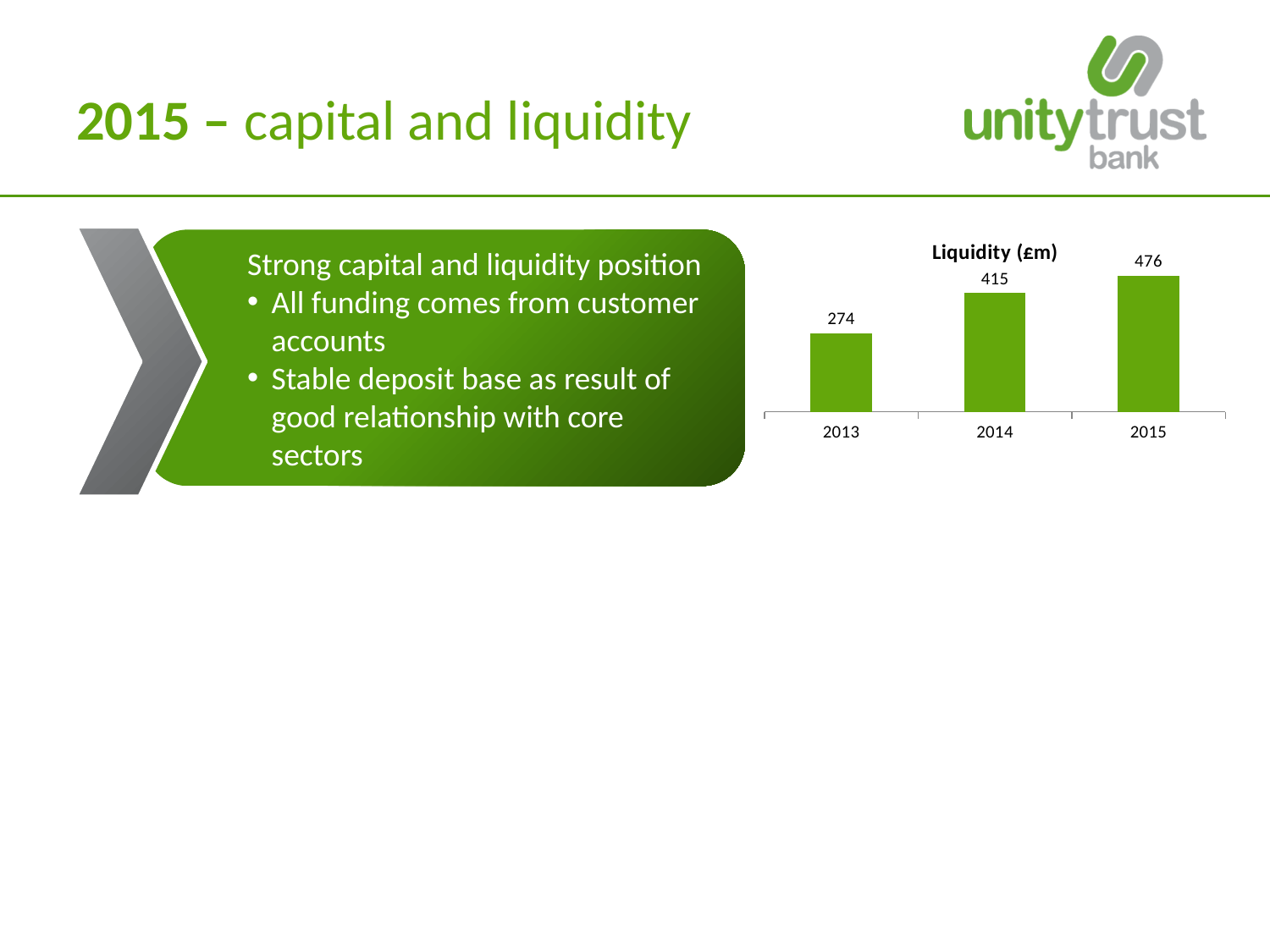
Does liquidity rise or fall from 2013 to 2015? Rise What is the difference in liquidity between 2015 and 2013? 202 Which year has higher liquidity, 2014 or 2015? 2015 What is the liquidity value for 2015? 476 Which year has the highest liquidity? 2015 What kind of chart is shown on the slide? Bar chart What is the liquidity value for 2013? 274 What is the difference in liquidity between 2014 and 2013? 141 Which year has the lowest liquidity? 2013 What is the title of the chart? Liquidity (£m) What is the liquidity value for 2014? 415 How many years are shown on the chart? 3